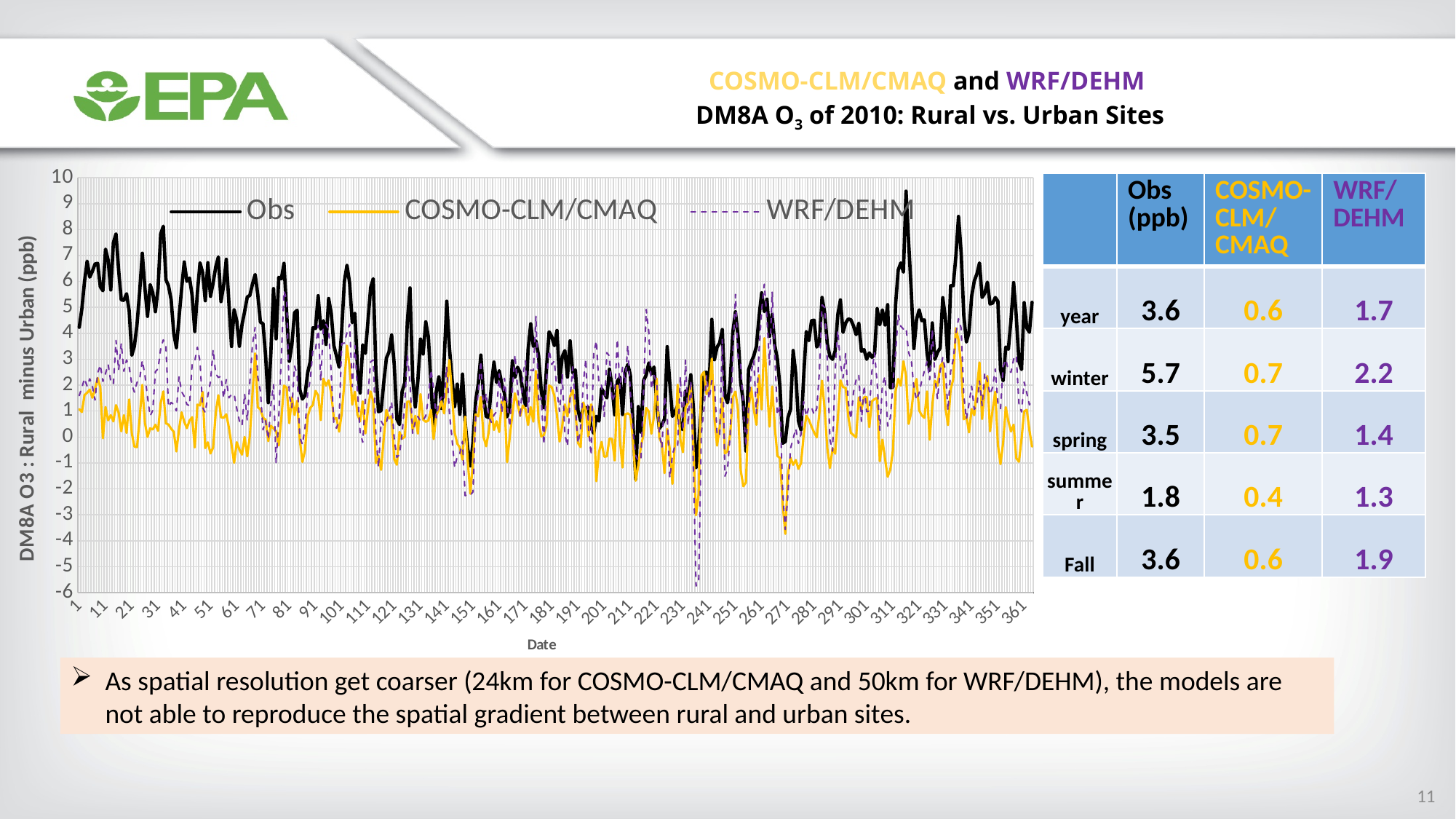
What kind of chart is shown on the slide? line chart Is the Obs value around day 31 greater or less than 5? greater Which series reaches the lowest value anywhere on the chart? WRF/DEHM How many series does the chart legend list? 3 Does the Obs series generally rise or fall between day 1 and day 151? fall What is the title of the chart's vertical axis? DM8A O3 : Rural minus Urban (ppb) Which series reaches the highest value anywhere on the chart? Obs Is the peak value of the Obs series around day 321 greater or less than 8? greater Around day 11, which series has the larger value: Obs or COSMO-CLM/CMAQ? Obs What is the highest tick value shown on the chart's vertical axis? 10 What are the three series named in the chart legend? Obs, COSMO-CLM/CMAQ, WRF/DEHM Is the lowest value of the WRF/DEHM series, near day 241, greater or less than -4? less